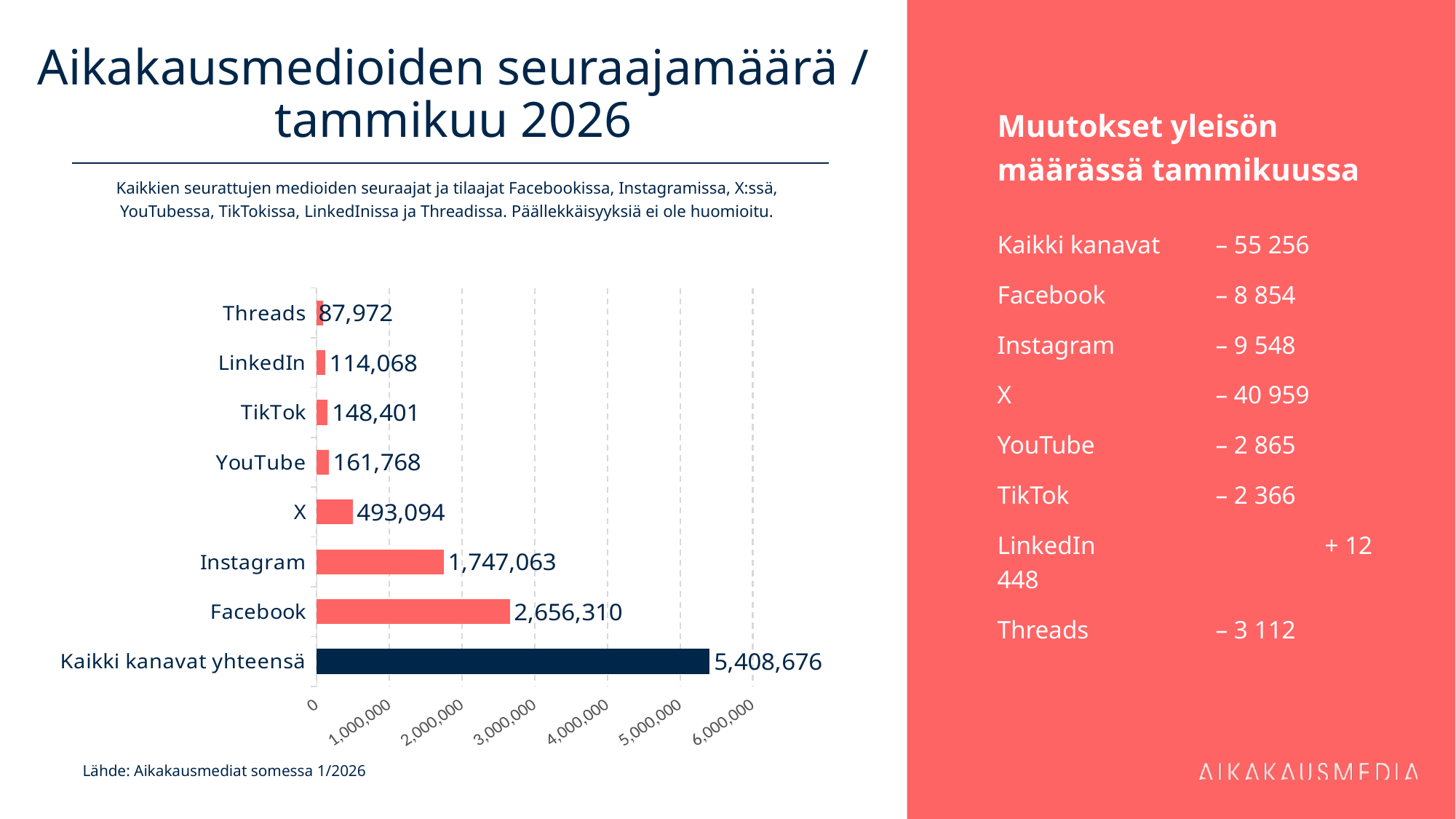
What is the value for TikTok? 148,401 What is the value for Kaikki kanavat yhteensä? 5,408,676 What is the value for Instagram? 1,747,063 What is the difference between the values for YouTube and TikTok? 13,367 What kind of chart is shown on the slide? Bar chart What is the value for Facebook? 2,656,310 Is the value for Facebook greater or less than 2,000,000? greater Which is larger, the value for Instagram or the value for X? Instagram Which category has the highest value? Kaikki kanavat yhteensä Which category has the lowest value? Threads What is the difference between the values for Facebook and Instagram? 909,247 How many bars are shown in the chart? 8